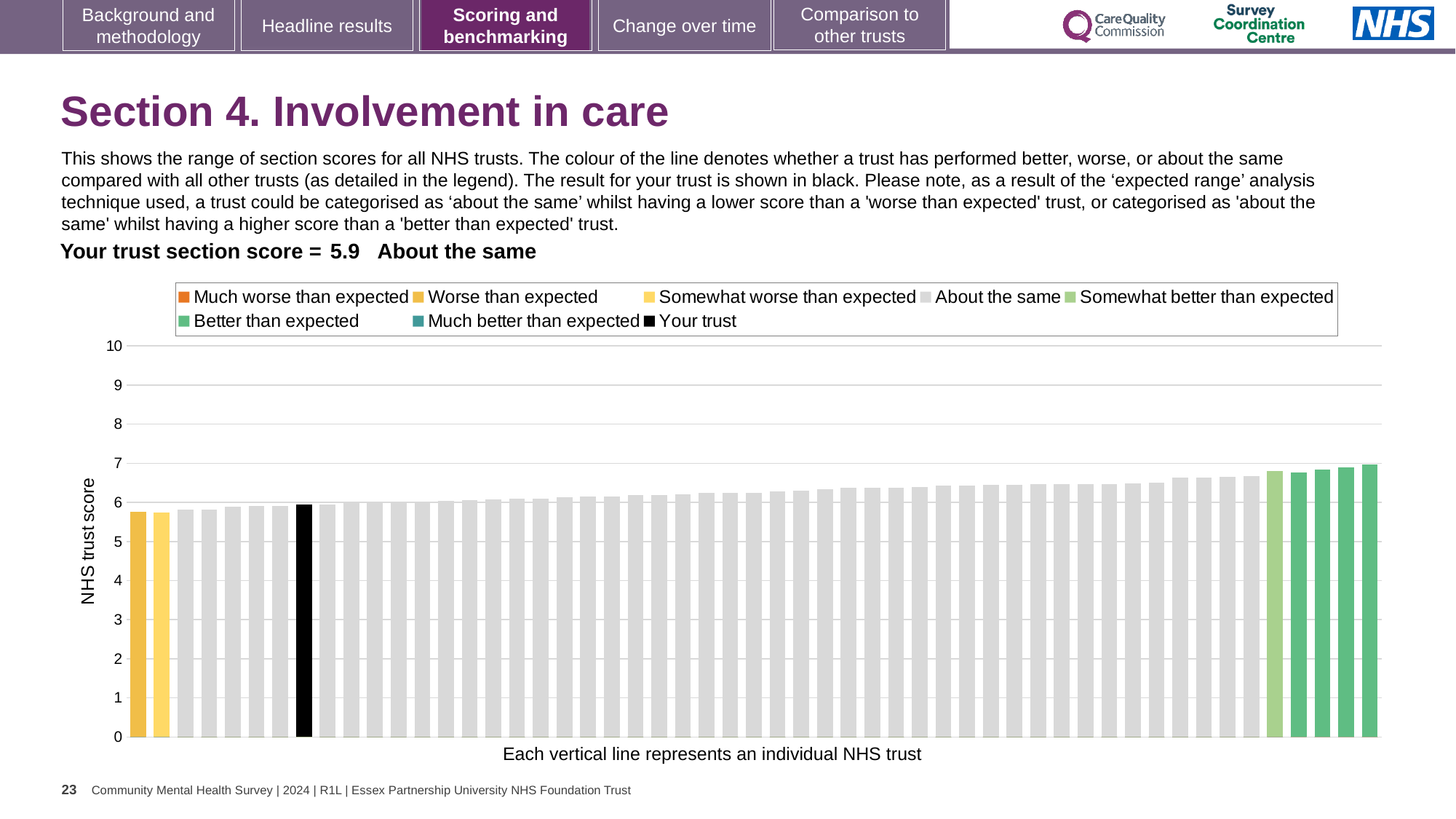
Which category does your trust's section score fall into? About the same Do the bar values rise or fall from left to right along the x axis? rise What is the label on the vertical axis of the chart? NHS trust score Is the value for the rightmost bar greater or less than 6? greater Is the value for the leftmost bar greater or less than 6? less What colour is the bar representing your trust? black What kind of chart is shown on the slide? bar chart How many entries does the chart legend list? 8 What is the section score for your trust shown on the slide? 5.9 Is the value for your trust's bar greater or less than 5? greater How many bars are coloured as 'Better than expected'? 4 How many bars are coloured as 'Worse than expected'? 1